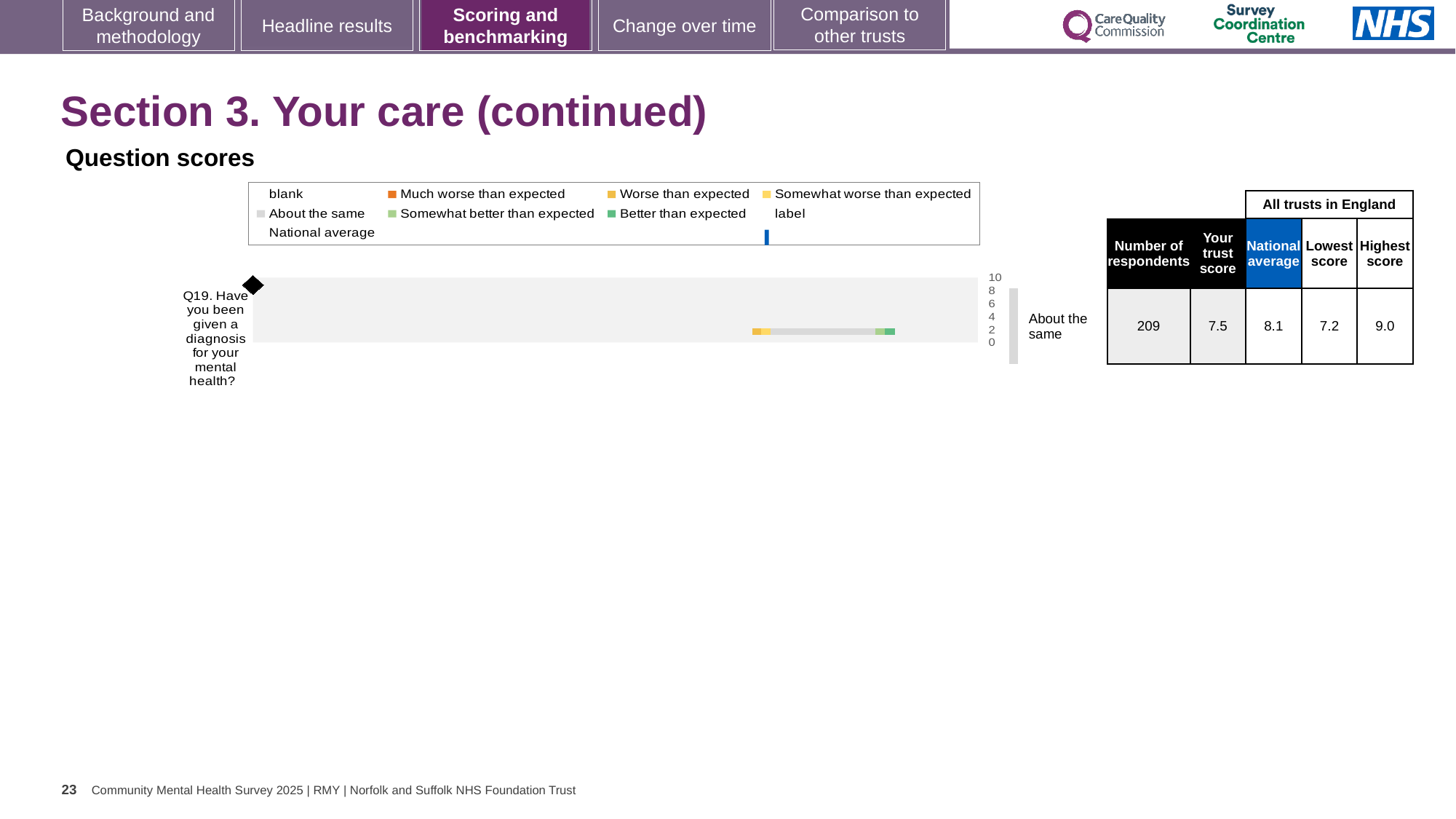
For Q19, what is the difference between the highest score and the lowest score among all trusts in England? 1.8 In the table beside the Question scores chart, what is the number of respondents for Q19? 209 For Q19, is the trust score higher or lower than the national average? lower In the table beside the Question scores chart, what is the lowest score among all trusts in England for Q19? 7.2 What is the maximum value shown on the axis of the Question scores chart? 10 What benchmark rating is shown next to the bar for Q19 in the Question scores chart? About the same In the table beside the Question scores chart, what is the highest score among all trusts in England for Q19? 9.0 How many questions are plotted in the Question scores chart? 1 For Q19, what is the difference between the national average and the trust score? 0.6 In the table beside the Question scores chart, what is the national average for Q19? 8.1 In the table beside the Question scores chart, what is 'Your trust score' for Q19? 7.5 What kind of chart is shown under 'Question scores'? bar chart